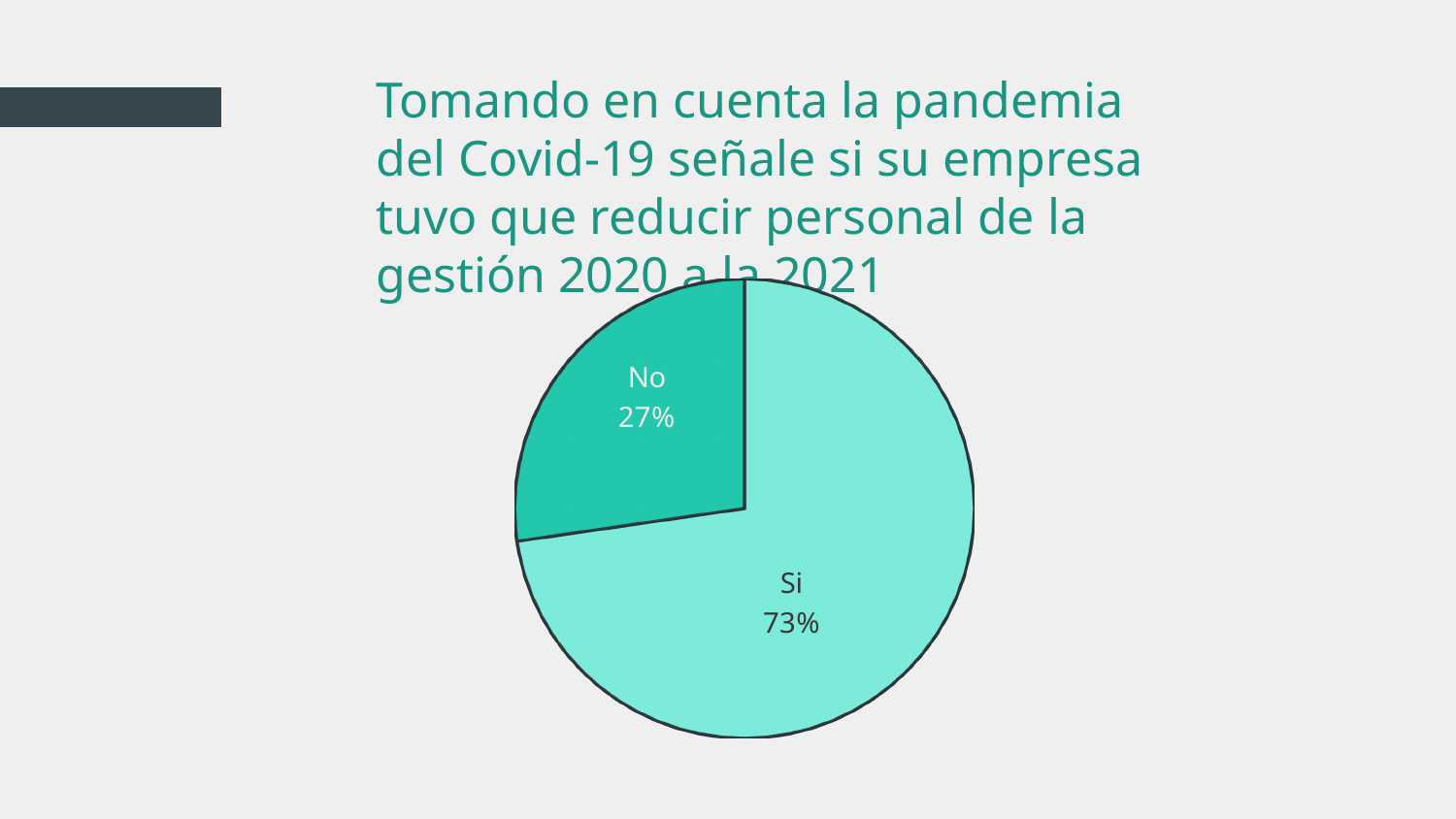
Which slice of the pie is the largest? Si What is the difference in percentage points between the "Si" and "No" slices? 46 Which is larger, the "Si" slice or the "No" slice? Si Which slice of the pie is the smallest? No What percentage of the pie is labelled "No"? 27% Which slice of the pie is drawn in the darker teal colour? No Is the "Si" slice greater or less than 50% of the pie? greater What is the combined percentage of the "Si" and "No" slices? 100% What kind of chart is shown on the slide? pie chart How many slices does the pie chart have? 2 What share of the pie does the "No" slice represent? 27% What percentage of the pie is labelled "Si"? 73%